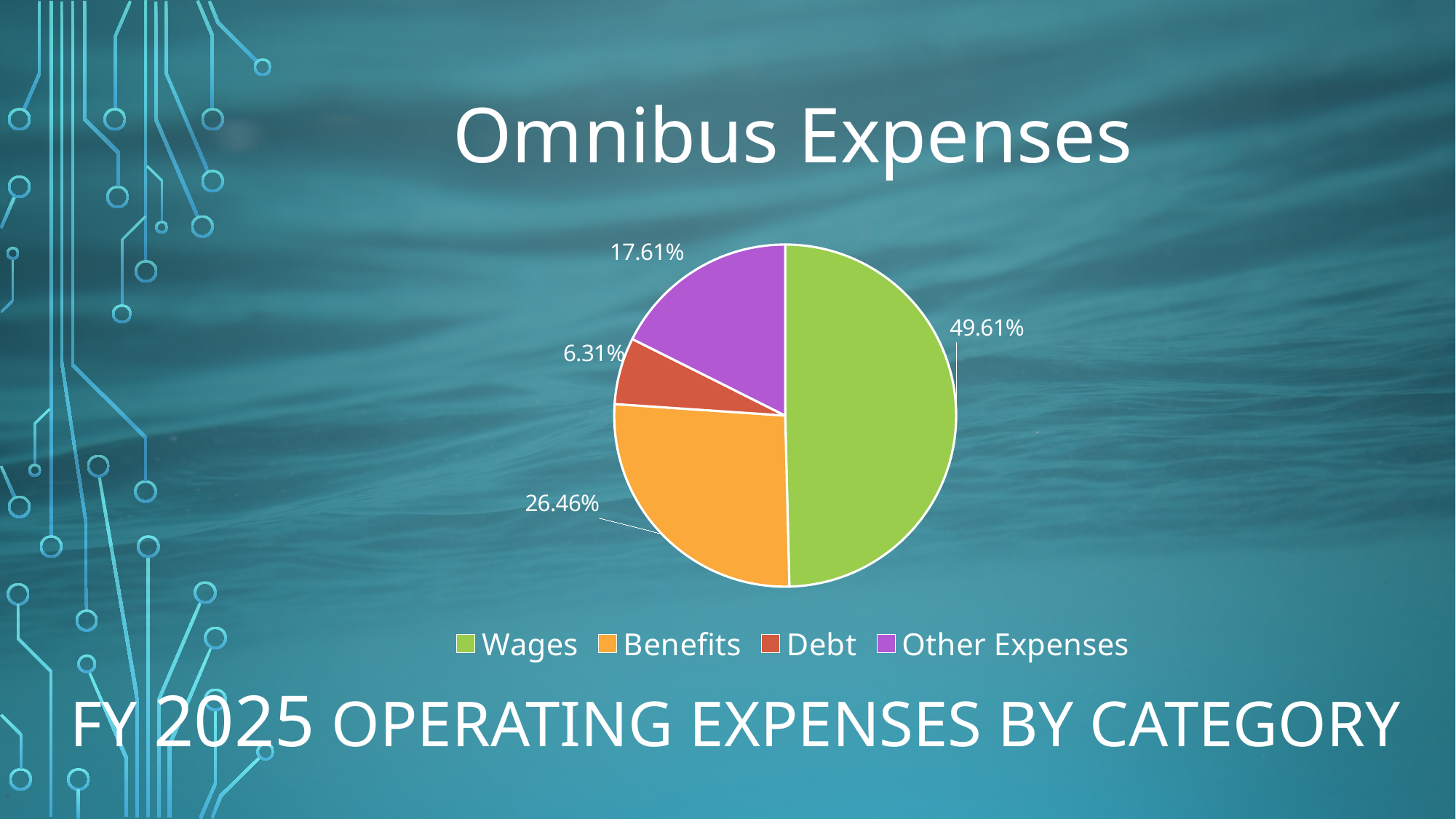
What share of the pie does Other Expenses account for? 17.61% What colour is the Benefits slice in the pie chart? Orange What type of chart is shown on the slide? Pie chart Which category has the largest slice of the pie? Wages What share of the pie does Debt account for? 6.31% What share of the pie does Wages account for? 49.61% What is the title of the chart? Omnibus Expenses Which is larger, the share for Other Expenses or the share for Debt? Other Expenses What is the difference in percentage points between Wages and Benefits? 23.15 How many categories are shown in the pie chart? 4 Which category has the smallest slice of the pie? Debt